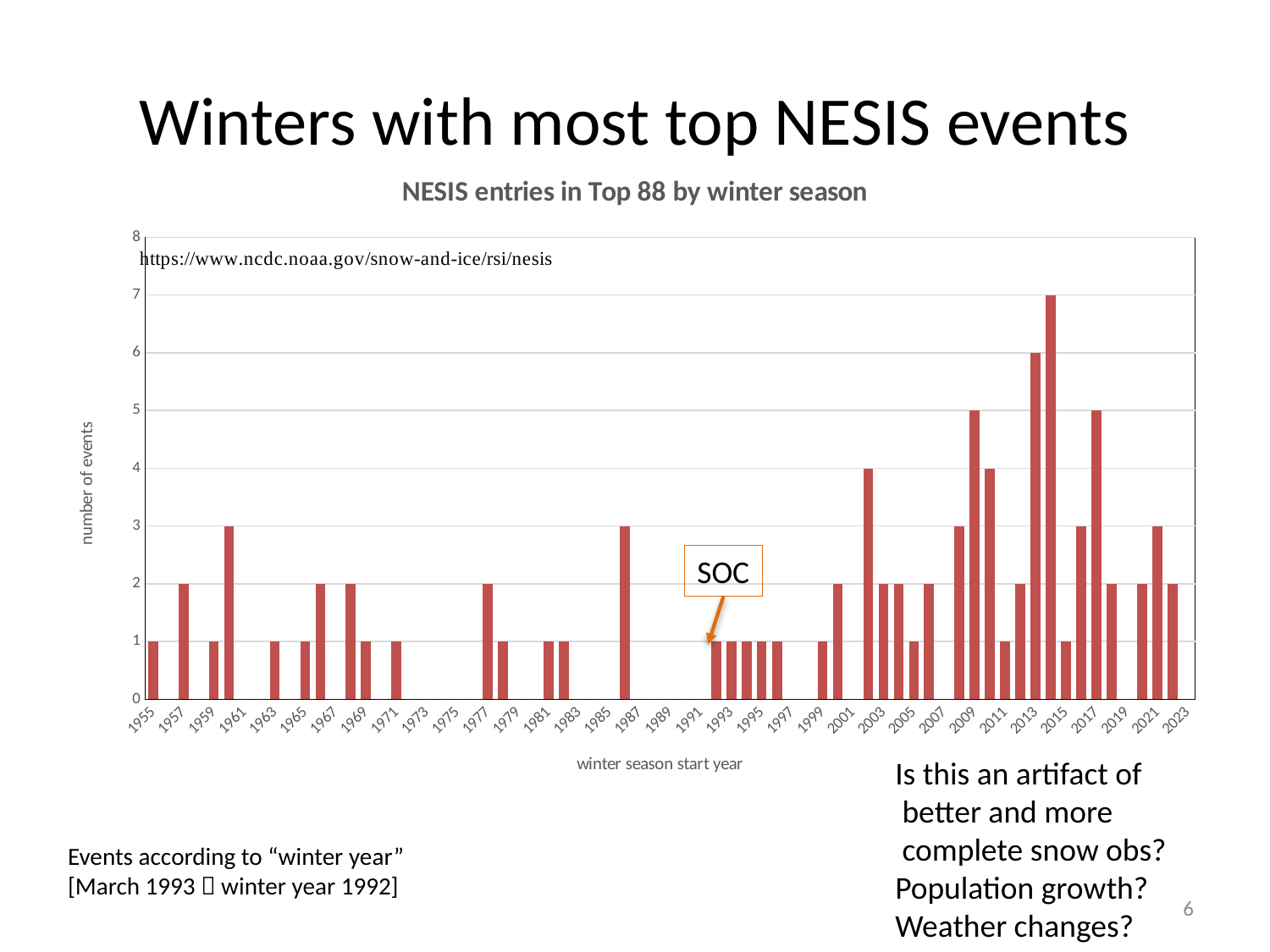
What is the difference in number of events between the 2013 and 2009 winter seasons? 1 What is the highest number of events shown for any winter season? 7 How many events are shown for the 1957 winter season? 2 How many events are shown for the 2013 winter season? 6 How many events are shown for the 2009 winter season? 5 Is the value for the 2017 winter season greater or less than 4? greater How many events are shown for the 1955 winter season? 1 What is the label of the vertical axis? number of events What is the title of the chart? NESIS entries in Top 88 by winter season Which winter season has more events, 2009 or 2013? 2013 What type of chart is shown on the slide? bar chart How many events are shown for the 2021 winter season? 3